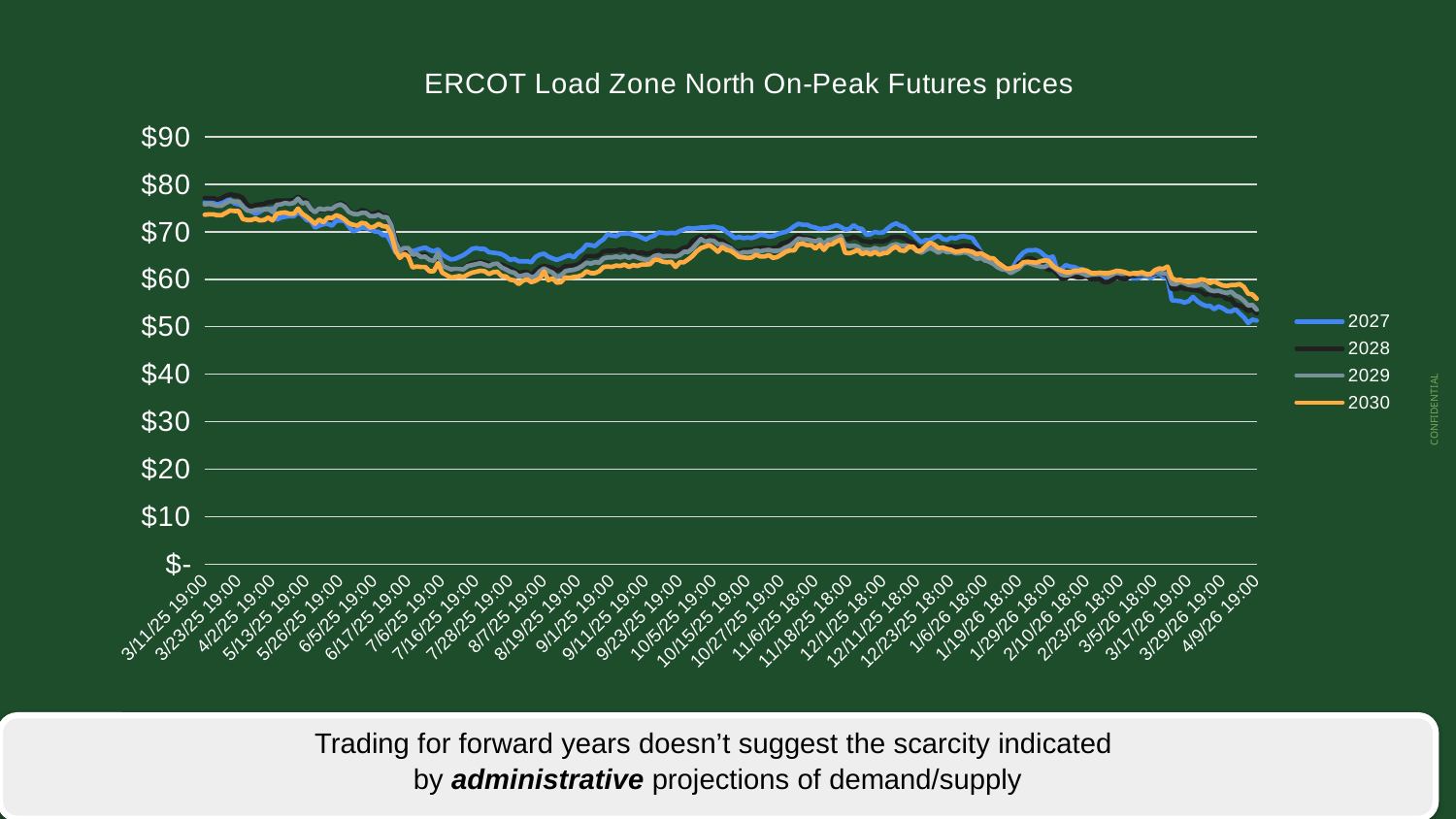
How many series does the legend list? 4 Is the value for 2030 at 4/9/26 19:00 greater or less than $60? less Which series has the lowest value at the start of the chart (3/11/25 19:00)? 2030 Which series is drawn in orange? 2030 Is the value for 2027 at 3/11/25 19:00 greater or less than $70? greater At 4/9/26 19:00, which is larger, the value for 2027 or the value for 2030? 2030 What is the title of the chart? ERCOT Load Zone North On-Peak Futures prices Which series has the lowest value at the end of the chart (4/9/26 19:00)? 2027 What is the highest value shown on the y axis? $90 Do the futures prices generally rise or fall from left to right along the x axis? fall Is the value for 2027 at 4/9/26 19:00 greater or less than $60? less What kind of chart is shown on the slide? line chart